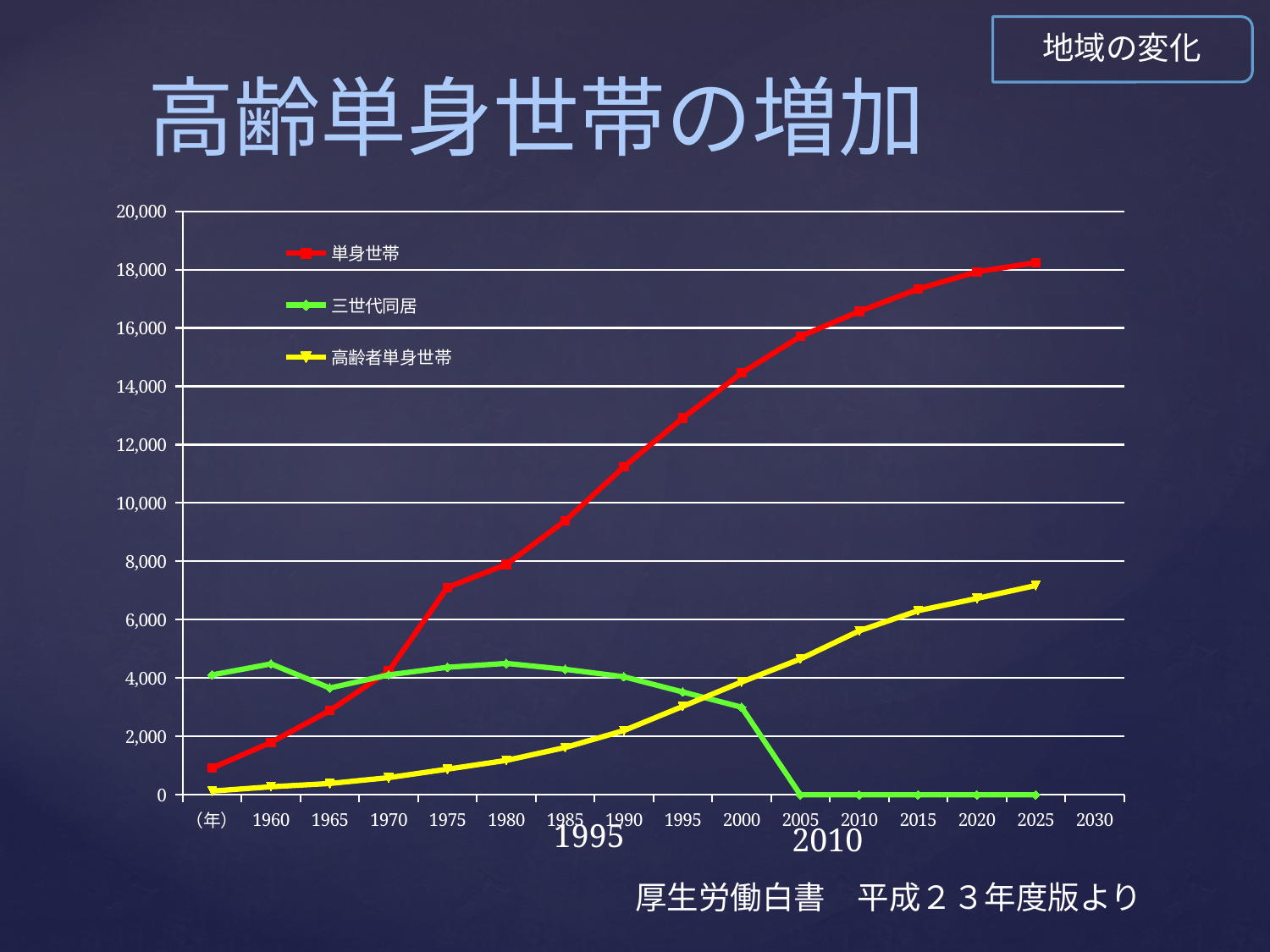
Is the value for 高齢者単身世帯 in 2025 greater or less than 6,000? greater In 2010, which is larger: 高齢者単身世帯 or 三世代同居? 高齢者単身世帯 In 1960, which is larger: 三世代同居 or 単身世帯? 三世代同居 Is the value for 単身世帯 in 1975 greater or less than 6,000? greater Does the 高齢者単身世帯 line rise or fall from 1960 to 2025? rise What is the title of the chart on the slide? 高齢単身世帯の増加 Which series is drawn in yellow in the chart? 高齢者単身世帯 How many series does the chart's legend list? 3 Which series has the highest value in 2025? 単身世帯 Is the value for 単身世帯 in 2025 greater or less than 16,000? greater What kind of chart is shown on the slide? line chart